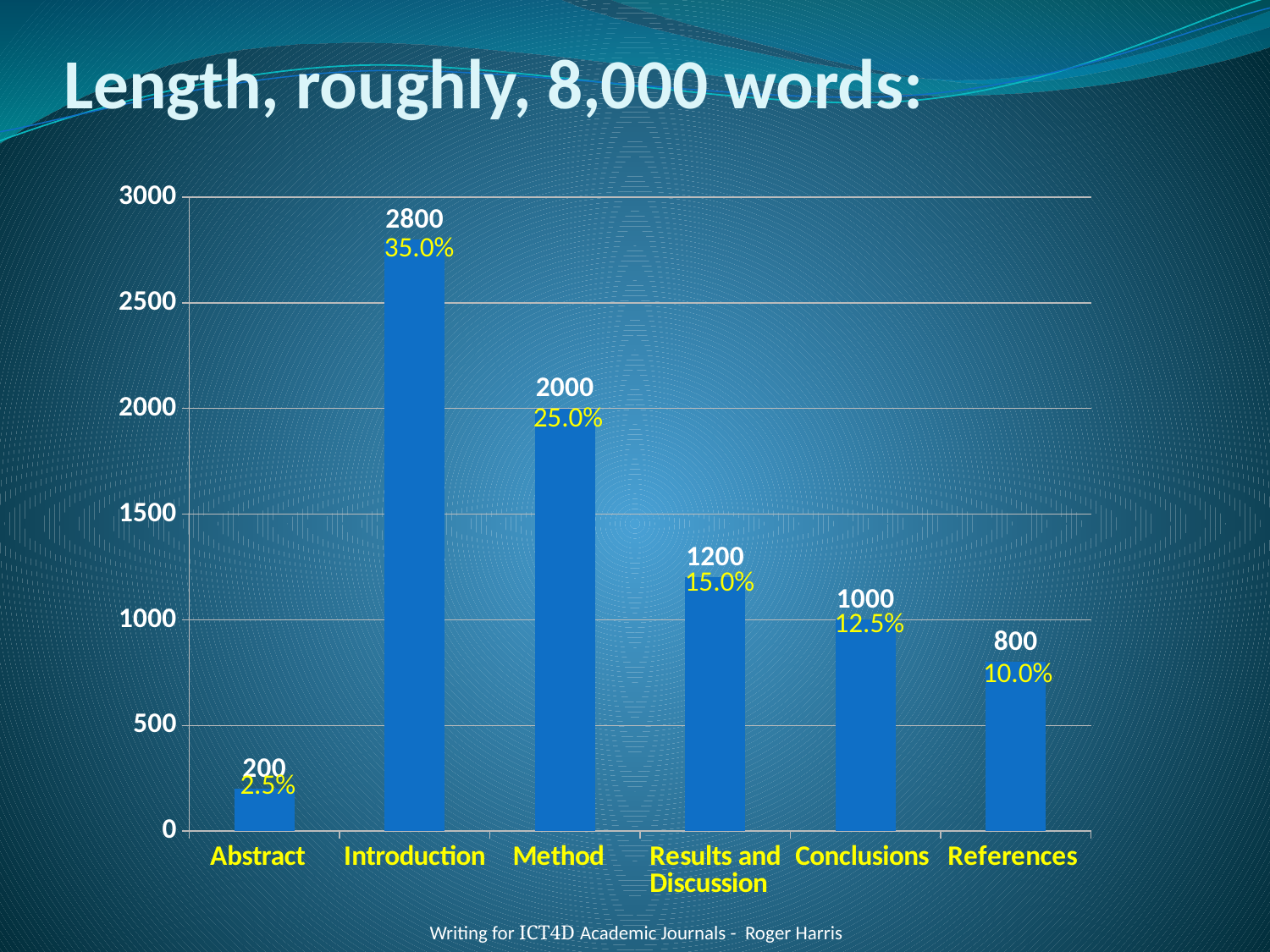
What is the value for Results and Discussion? 1200 What kind of chart is shown on the slide? bar chart Which is larger, the value for Conclusions or the value for References? Conclusions What is the title of the slide? Length, roughly, 8,000 words: How many categories are shown on the x axis? 6 Which category has the lowest value? Abstract What percentage is shown for Conclusions? 12.5% What is the value for Introduction? 2800 Is the value for Results and Discussion greater or less than 1000? greater Which category has the highest value? Introduction What is the value for Method? 2000 What is the difference between the values for Introduction and Method? 800